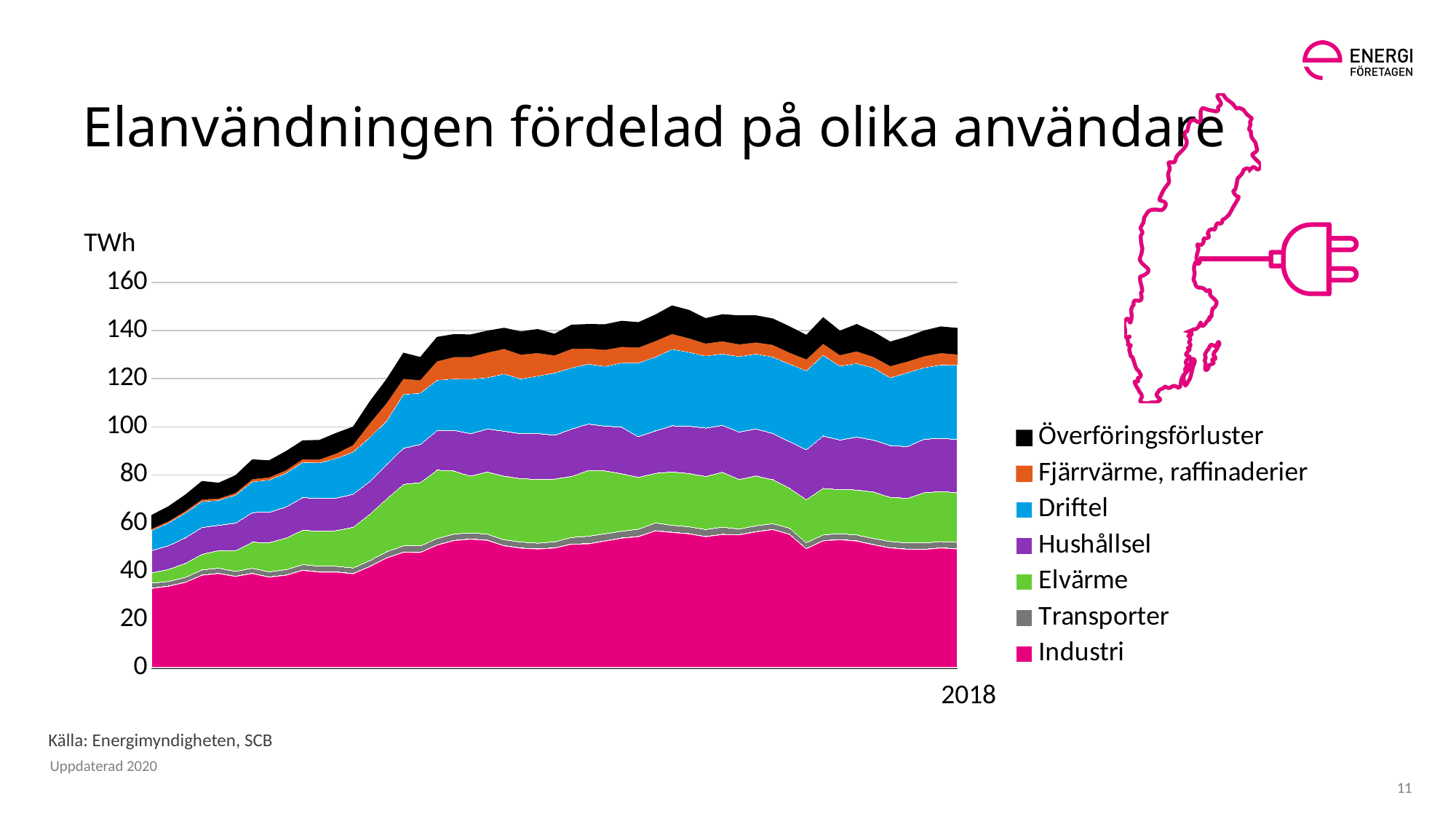
How many series does the legend list? 7 Which series is shown in black in the chart? Överföringsförluster What kind of chart is shown on the slide? Stacked area chart Is the value for Industri in 2018 greater or less than 60 TWh? less Which series occupies the smallest area of the chart? Transporter Is the total electricity use in 2018 greater or less than 120 TWh? greater Does the total electricity use rise or fall from the left of the chart to the right? rise Is the value for Industri in 2018 greater or less than 40 TWh? greater What unit is shown on the y axis of the chart? TWh Which is larger in 2018, Industri or Transporter? Industri What is the title of the chart on the slide? Elanvändningen fördelad på olika användare Which series occupies the largest area of the chart? Industri